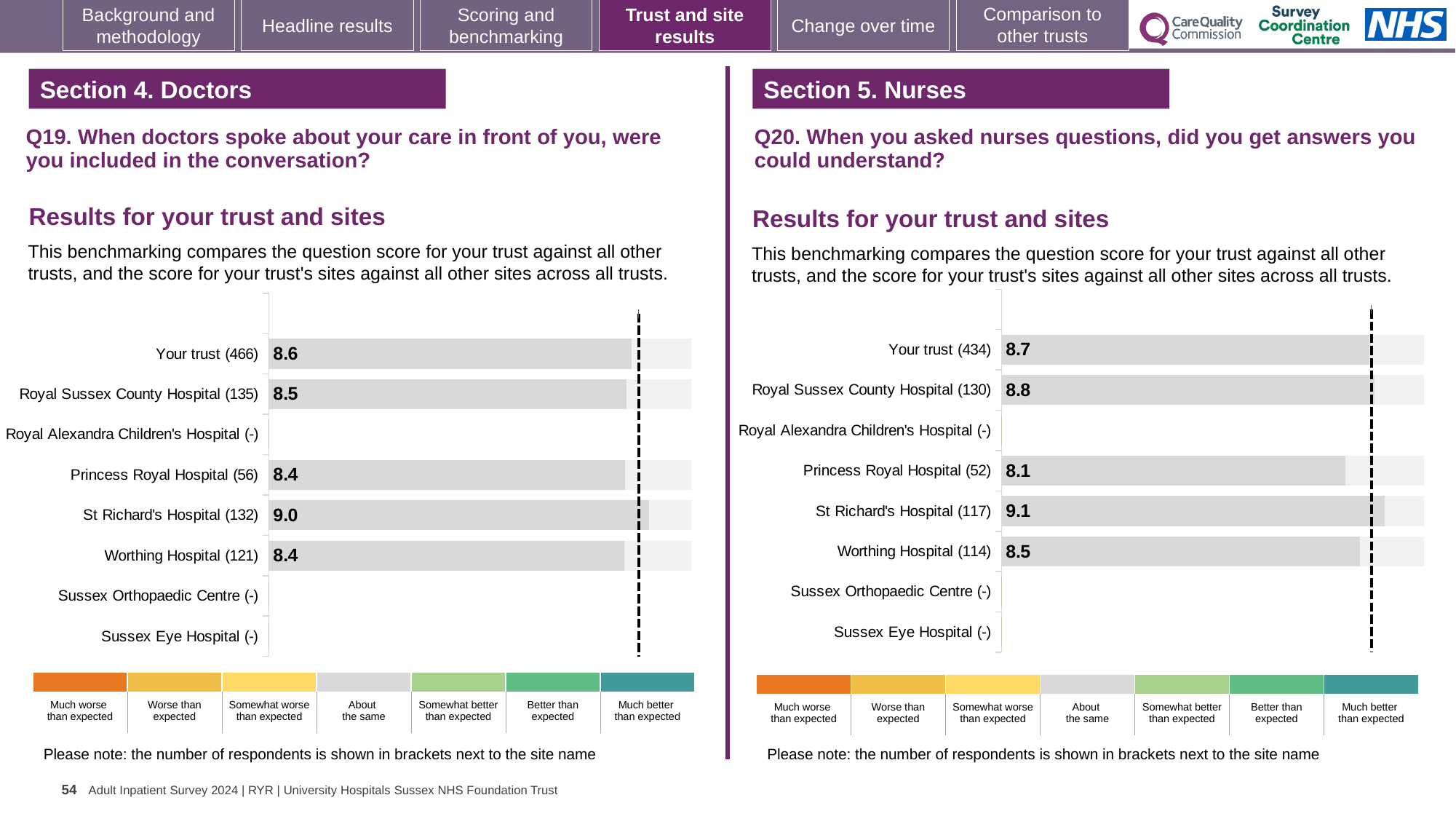
In the Q19 chart (left), what is the difference between the scores for St Richard's Hospital and Worthing Hospital? 0.6 In the Q19 chart (left), how many respondents are shown for Royal Sussex County Hospital? 135 In the Q20 chart (right), what is the score for Princess Royal Hospital? 8.1 In the Q20 chart (right), which is larger, the score for Royal Sussex County Hospital or the score for Worthing Hospital? Royal Sussex County Hospital In the Q19 chart (left), which site has the highest score? St Richard's Hospital What type of chart is used for the Q20 results (right)? Bar chart How many site rows (including Your trust) are listed in the Q19 chart (left)? 8 In the Q20 chart (right), what is the difference between the scores for St Richard's Hospital and Your trust? 0.4 In the Q19 chart (left), what is the score for St Richard's Hospital? 9.0 In the Q20 chart (right), how many respondents are shown for Your trust? 434 In the Q19 chart (left), what is the score for Your trust? 8.6 In the Q20 chart (right), which site has the lowest score? Princess Royal Hospital